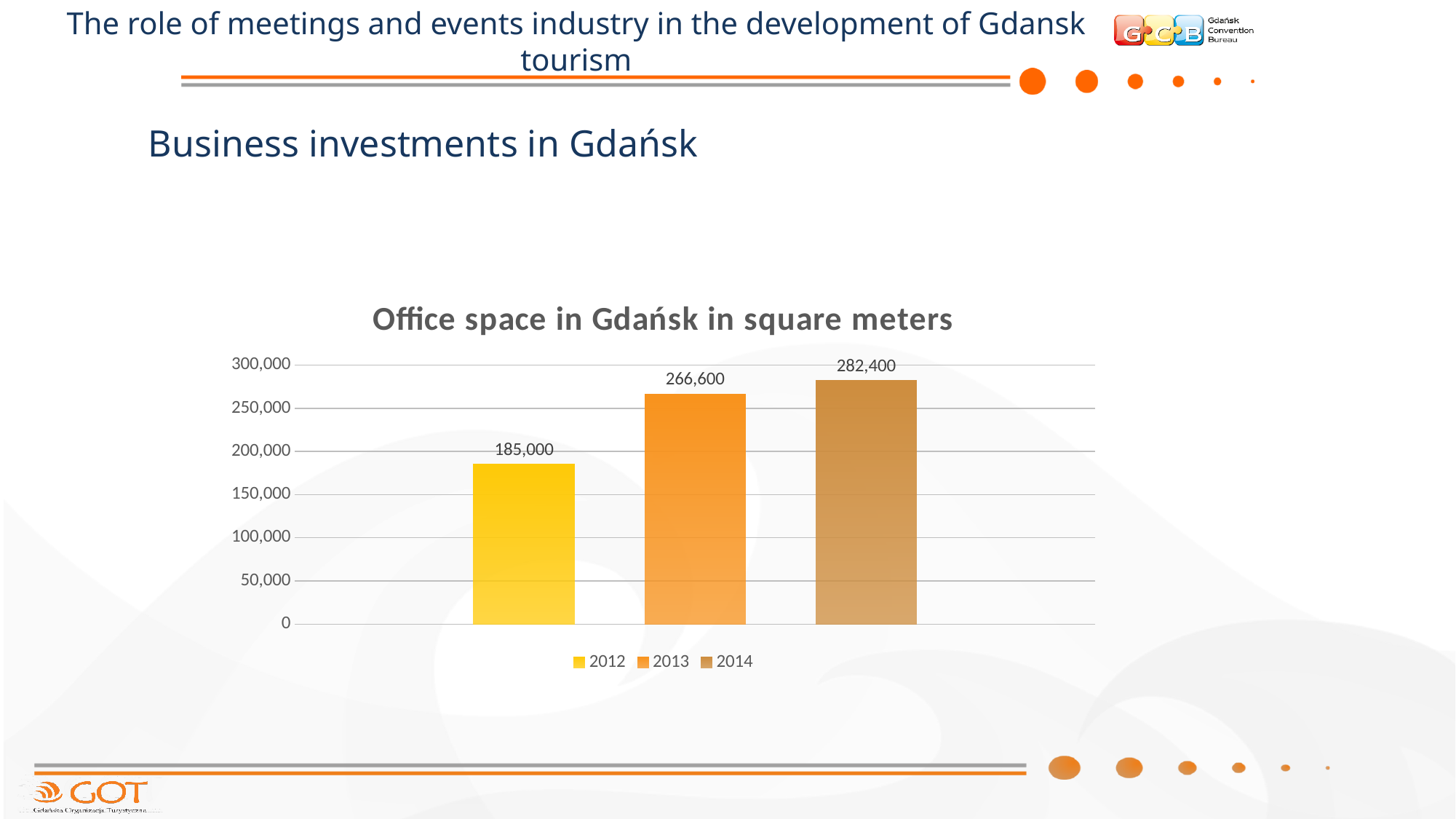
Which is larger, the office space in 2012 or in 2013? 2013 Is the value for 2012 greater or less than 200,000? less What is the difference in office space between 2014 and 2013? 15,800 What is the difference in office space between 2013 and 2012? 81,600 What is the office space in Gdańsk for 2013? 266,600 Which year has the highest office space value? 2014 What is the title of the chart? Office space in Gdańsk in square meters How many bars are shown in the chart? 3 What is the office space in Gdańsk for 2012? 185,000 What kind of chart is shown on the slide? bar chart What is the office space in Gdańsk for 2014? 282,400 Which year has the lowest office space value? 2012